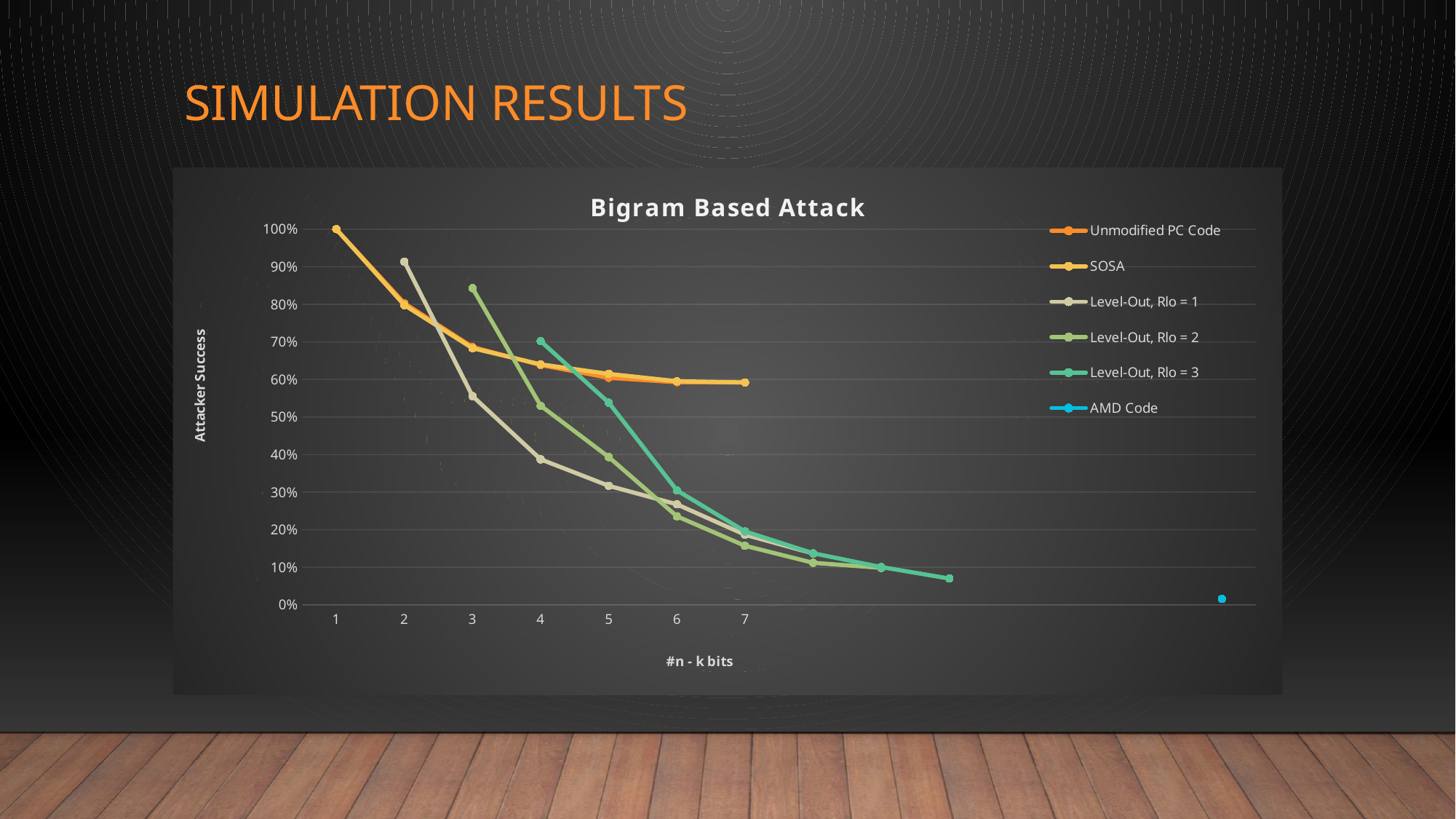
Is the value for Level-Out, Rlo = 3 at #n - k bits = 6 greater or less than 40%? less Is the value for Level-Out, Rlo = 2 at #n - k bits = 3 greater or less than 80%? greater Is the value for Level-Out, Rlo = 1 at #n - k bits = 3 greater or less than 50%? greater What is the value for Unmodified PC Code at #n - k bits = 1? 100% What is the title of the chart? Bigram Based Attack How many labeled tick values are shown on the x axis (#n - k bits)? 7 At #n - k bits = 6, which is larger: Unmodified PC Code or Level-Out, Rlo = 2? Unmodified PC Code Do the values for Level-Out, Rlo = 2 rise or fall as #n - k bits increases? fall What type of chart is shown on the slide? line chart At #n - k bits = 4, which is larger: Level-Out, Rlo = 3 or Level-Out, Rlo = 1? Level-Out, Rlo = 3 How many series does the legend list? 6 What is the label of the vertical axis? Attacker Success